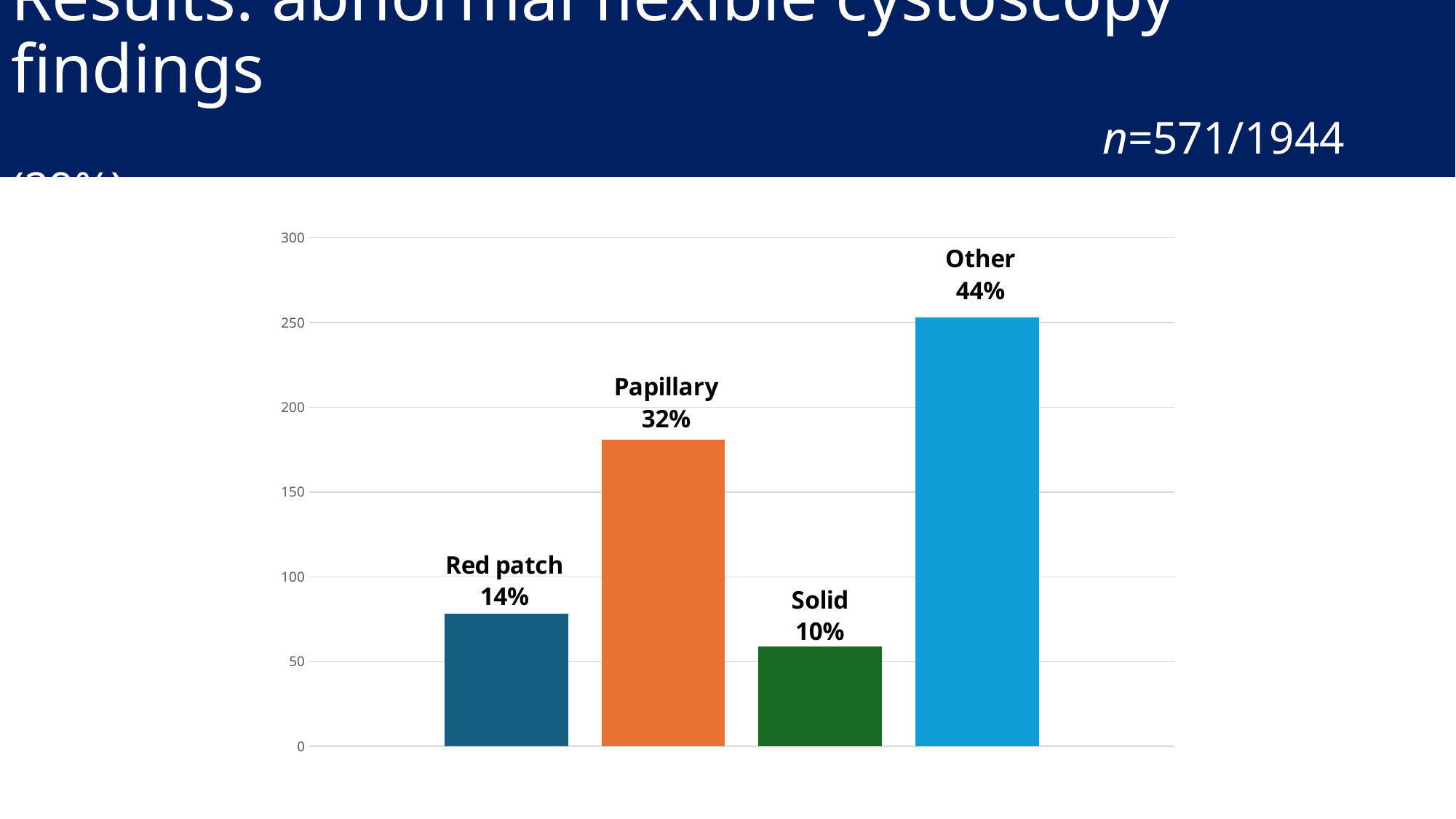
What percentage label is shown for the Papillary bar? 32% What percentage label is shown for the Solid bar? 10% Which category has the lowest bar? Solid How many categories are shown in the chart? 4 What kind of chart is shown on the slide? Bar chart What percentage label is shown for the Other bar? 44% What is the difference in percentage points between the Other and Papillary labels? 12 percentage points Which is larger, the Red patch bar or the Papillary bar? Papillary Which category has the highest bar? Other What percentage label is shown for the Red patch bar? 14% Is the value for Papillary greater or less than 150? greater Is the value for Red patch greater or less than 100? less